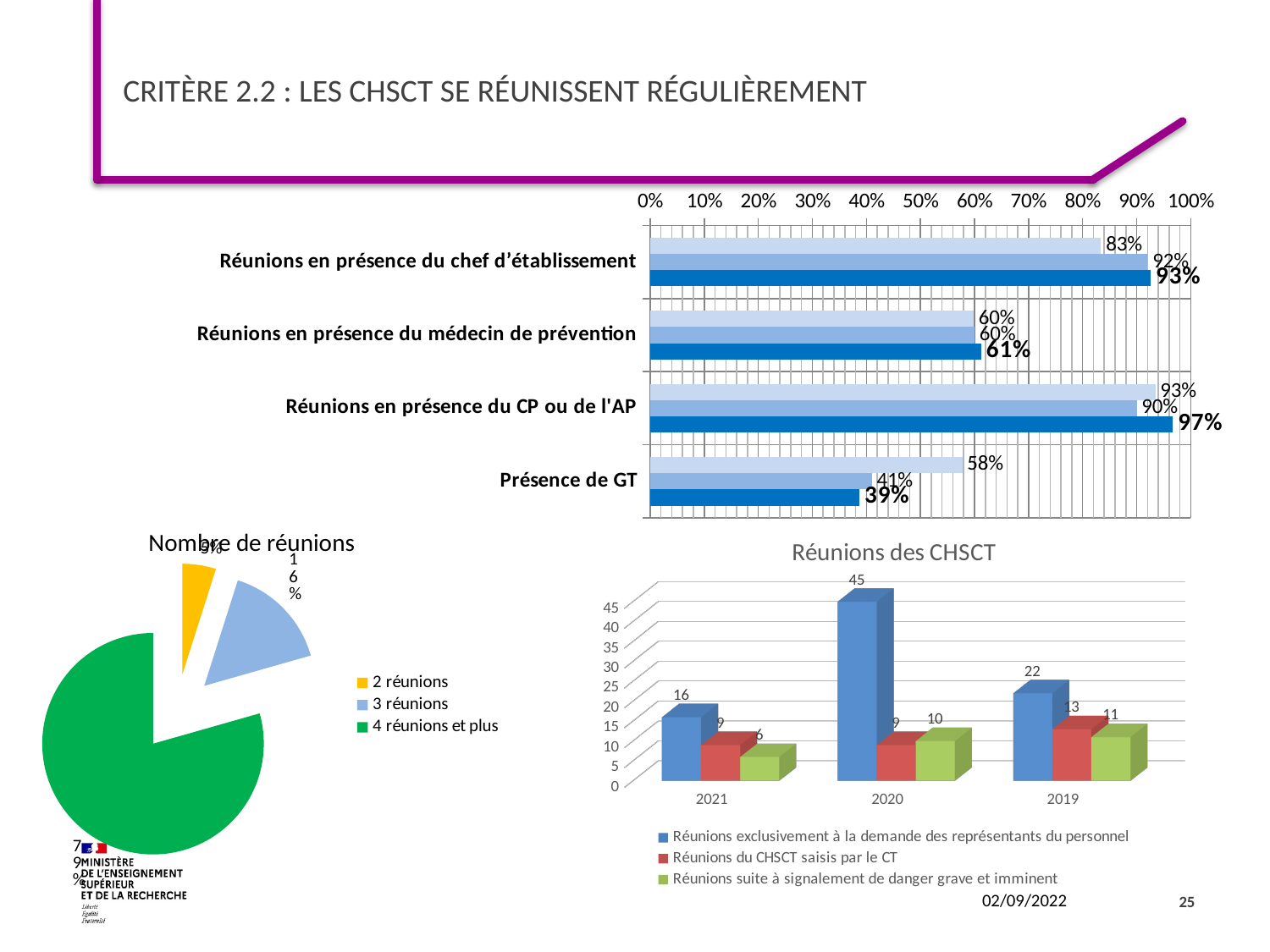
In the 'Réunions des CHSCT' chart, which is larger in 2019: 'Réunions du CHSCT saisis par le CT' or 'Réunions suite à signalement de danger grave et imminent'? Réunions du CHSCT saisis par le CT In the 'Réunions des CHSCT' chart, what is the value for 'Réunions exclusivement à la demande des représentants du personnel' in 2020? 45 In the top-right horizontal bar chart, what is the value of the top (light blue) bar for 'Présence de GT'? 58% In the 'Nombre de réunions' chart, which slice is the largest? 4 réunions et plus In the top-right horizontal bar chart, how many categories are shown? 4 In the 'Réunions des CHSCT' chart, what is the value for 'Réunions du CHSCT saisis par le CT' in 2019? 13 In the top-right horizontal bar chart, what is the value of the bottom (dark blue) bar for 'Réunions en présence du CP ou de l'AP'? 97% In the 'Réunions des CHSCT' chart, what is the difference between the 2020 and 2021 values for 'Réunions exclusivement à la demande des représentants du personnel'? 29 In the 'Réunions des CHSCT' chart, which year has the highest value for 'Réunions exclusivement à la demande des représentants du personnel'? 2020 In the 'Réunions des CHSCT' chart, what is the value for 'Réunions suite à signalement de danger grave et imminent' in 2021? 6 In the 'Réunions des CHSCT' chart, how many series does the legend list? 3 In the 'Réunions des CHSCT' chart, how many years are shown on the x axis? 3